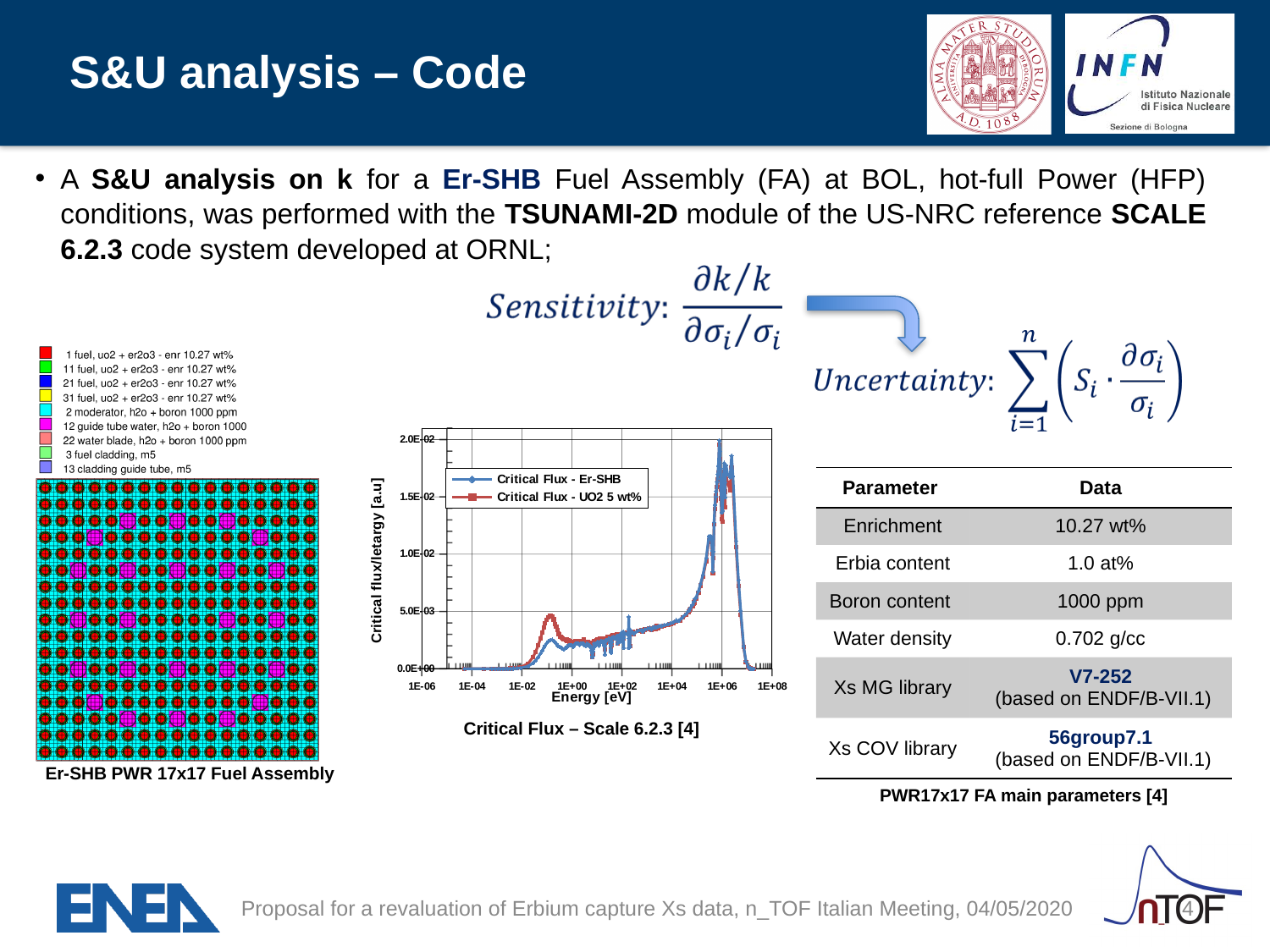
What is the x-axis label of the 'Critical Flux – Scale 6.2.3 [4]' chart? Energy [eV] What kind of chart is the 'Critical Flux – Scale 6.2.3 [4]' chart? line chart In the 'Critical Flux – Scale 6.2.3 [4]' chart, is the peak value of the Critical Flux - Er-SHB series greater or less than 1.5E-02? greater In the 'Critical Flux – Scale 6.2.3 [4]' chart, is the value of the Critical Flux - UO2 5 wt% series at 1E-02 eV greater or less than 1.0E-02? less What are the two series named in the legend of the 'Critical Flux – Scale 6.2.3 [4]' chart? Critical Flux - Er-SHB and Critical Flux - UO2 5 wt% In the 'Critical Flux – Scale 6.2.3 [4]' chart, does the critical flux rise or fall as energy increases from 1E+06 eV to 1E+08 eV? fall In the 'Critical Flux – Scale 6.2.3 [4]' chart, is the value of the Critical Flux - Er-SHB series at 1E-04 eV greater or less than 5.0E-03? less In the 'Critical Flux – Scale 6.2.3 [4]' chart, does the critical flux rise or fall as energy increases from 1E+02 eV to 1E+06 eV? rise How many series does the legend of the 'Critical Flux – Scale 6.2.3 [4]' chart list? 2